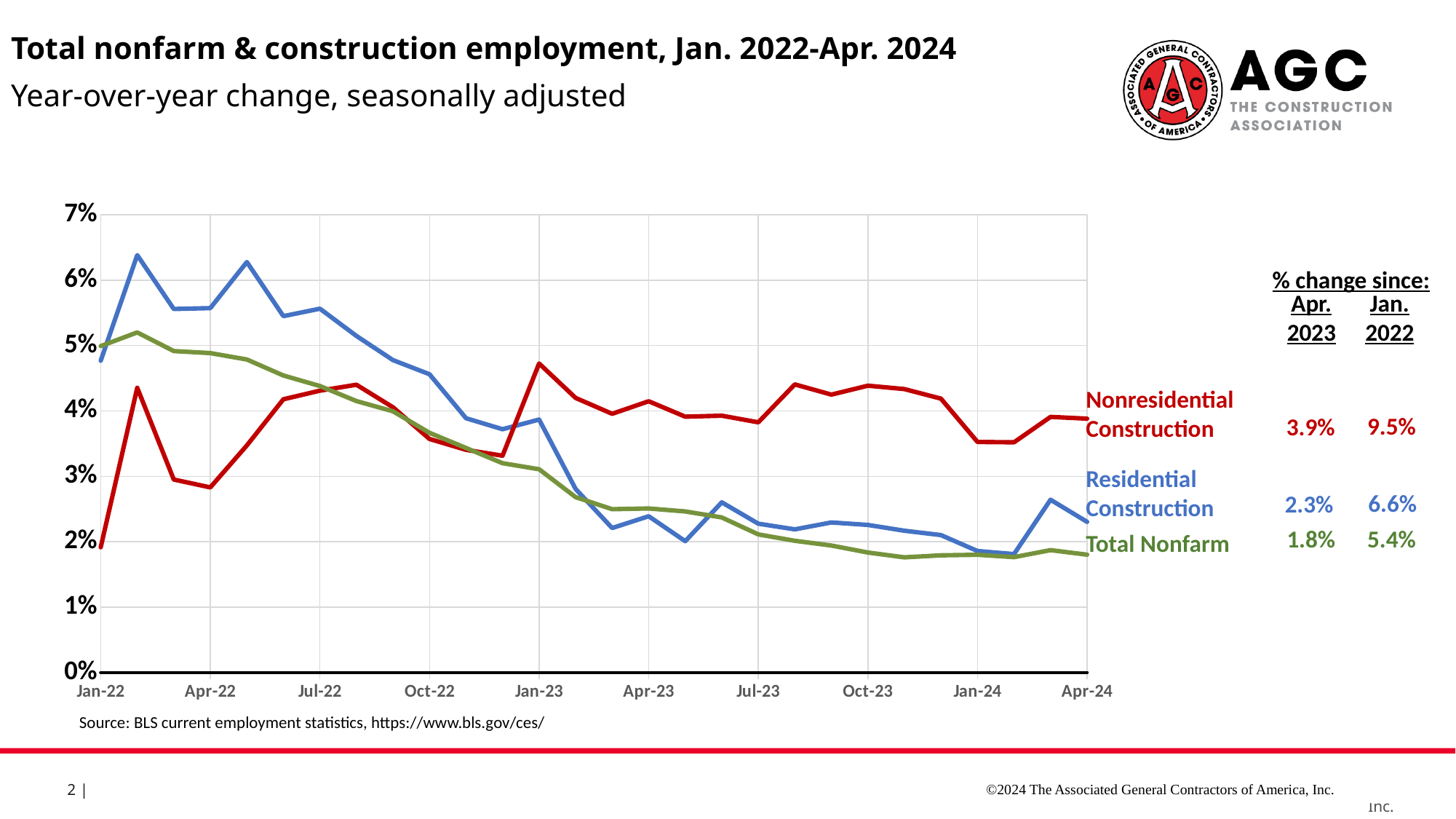
What kind of chart is shown on the slide? line chart Which series shows the largest % change since Jan. 2022 in the table beside the chart? Nonresidential Construction What is the difference between the % change since Jan. 2022 for Nonresidential Construction and for Residential Construction, as shown in the table? 2.9 percentage points How many series are plotted on the chart? 3 Which series shows the smallest % change since Apr. 2023 in the table beside the chart? Total Nonfarm Does the Total Nonfarm line generally rise or fall from Jan-22 to Apr-24? fall Is the year-over-year change for Residential Construction at Apr-23 greater or less than 3%? less At Jan-22, which series has the higher year-over-year change: Residential Construction or Nonresidential Construction? Residential Construction According to the table beside the chart, what is the % change in Residential Construction employment since Apr. 2023? 2.3% According to the table beside the chart, what is the % change in Nonresidential Construction employment since Jan. 2022? 9.5% According to the table beside the chart, what is the % change in Total Nonfarm employment since Jan. 2022? 5.4% Is the year-over-year change for Residential Construction at Jan-22 greater or less than 4%? greater